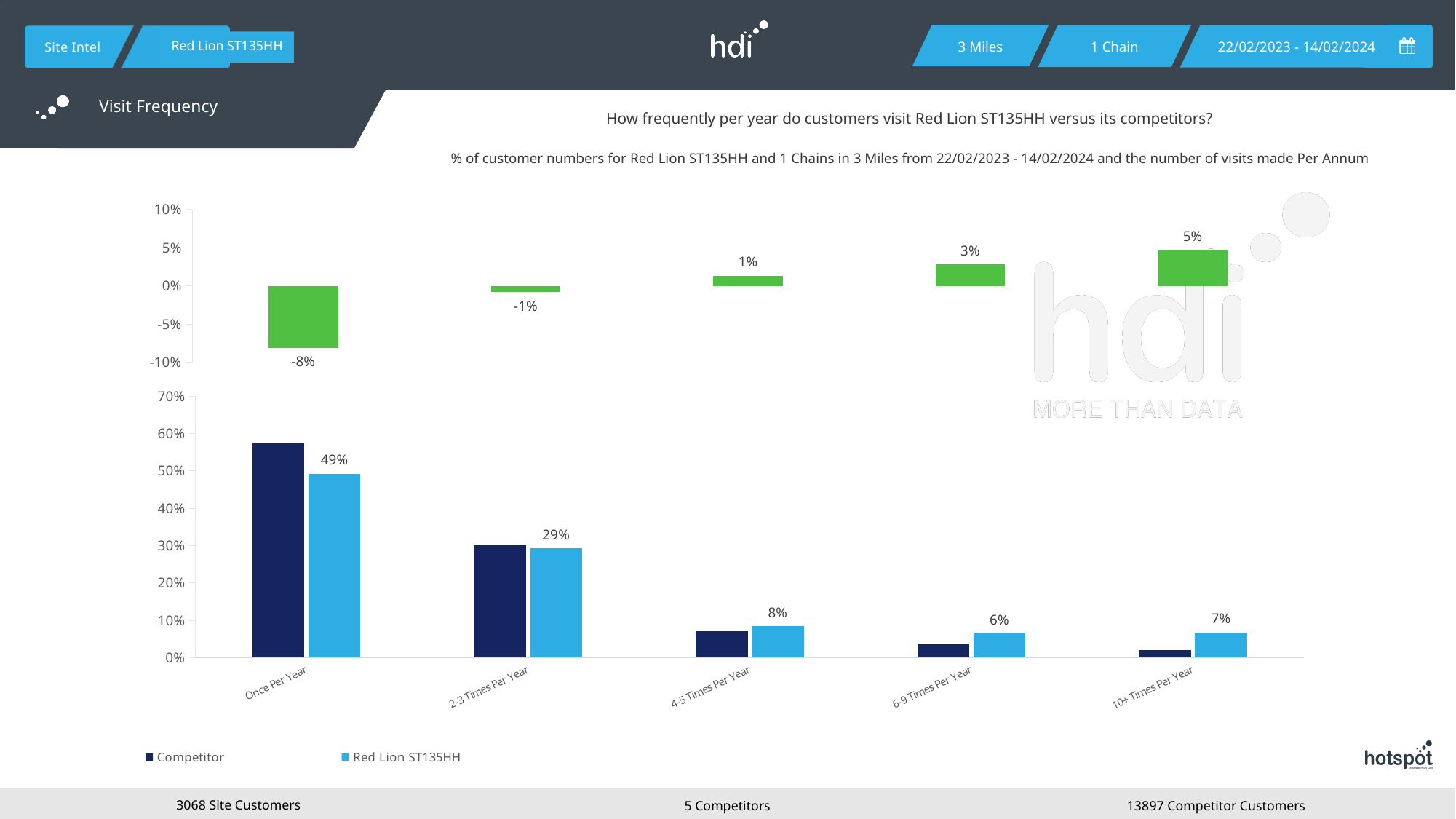
In the bottom chart, which is larger for 4-5 Times Per Year: Competitor or Red Lion ST135HH? Red Lion ST135HH In the bottom chart, what is the value for Red Lion ST135HH in the 10+ Times Per Year category? 7% In the top chart, what is the value shown for the 10+ Times Per Year category? 5% What type of chart is the bottom chart? Bar chart In the bottom chart, which category has the highest Red Lion ST135HH value? Once Per Year In the bottom chart, what is the value for Red Lion ST135HH in the Once Per Year category? 49% How many series does the legend of the bottom chart list? 2 In the bottom chart, what is the value for Red Lion ST135HH in the 2-3 Times Per Year category? 29% In the bottom chart, what is the difference between the Red Lion ST135HH values for Once Per Year and 2-3 Times Per Year? 20% In the top chart, which category has the lowest value? Once Per Year In the top chart, what is the value shown for the Once Per Year category? -8% In the bottom chart, is the Competitor value for Once Per Year greater or less than 50%? greater